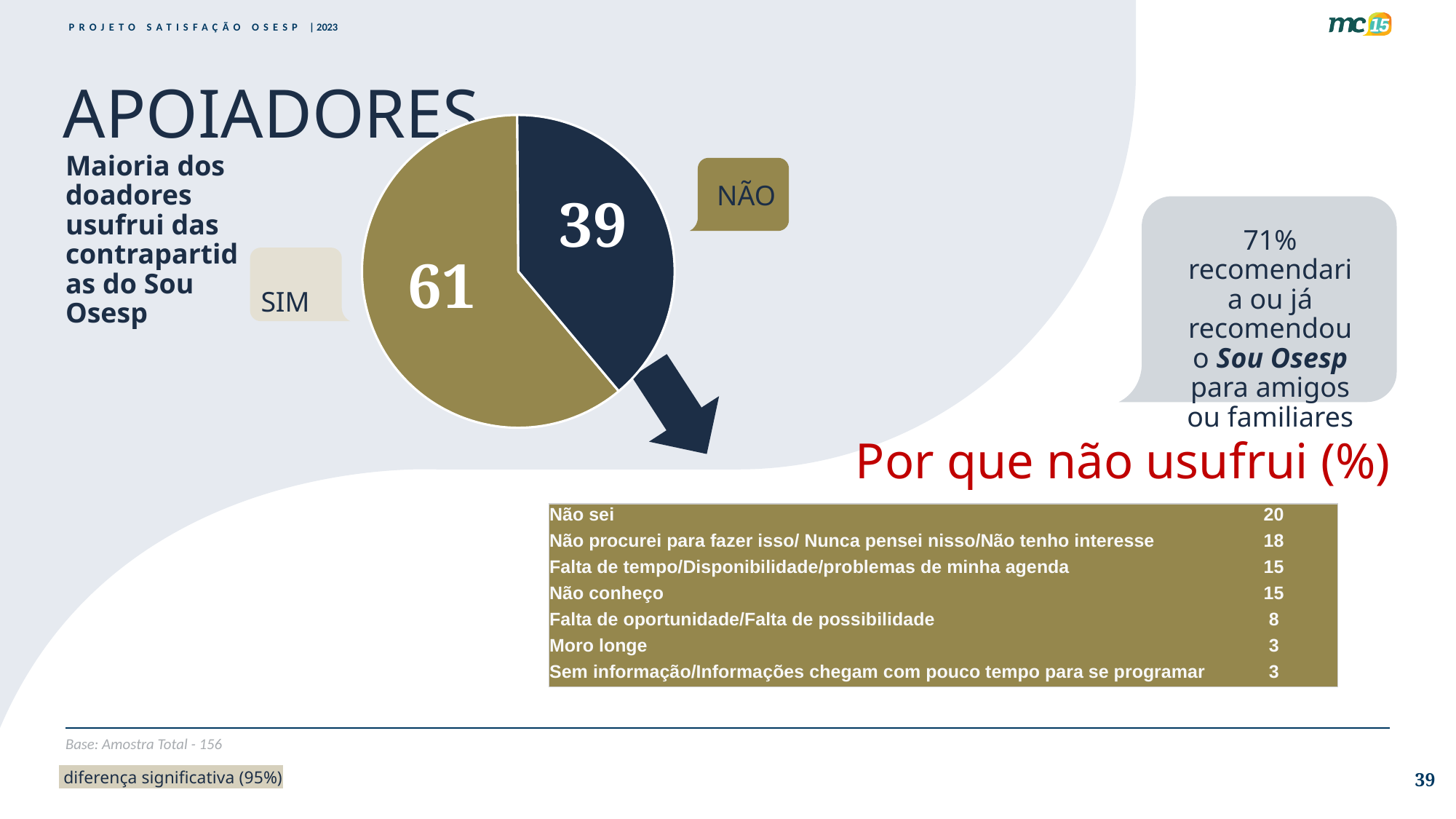
What kind of chart is shown on the slide? Pie chart How many slices does the pie chart have? 2 Which slice of the pie chart is the smallest? NÃO Which slice of the pie chart is the largest? SIM What colour is the NÃO slice of the pie chart? Dark navy blue What value is shown for the NÃO slice of the pie chart? 39 What is the difference between the SIM and NÃO values in the pie chart? 22 What colour is the SIM slice of the pie chart? Gold/olive Which is larger in the pie chart, SIM or NÃO? SIM What value is shown for the SIM slice of the pie chart? 61 What is the total of the two values shown in the pie chart? 100 What share of the pie chart does the SIM slice represent? 61